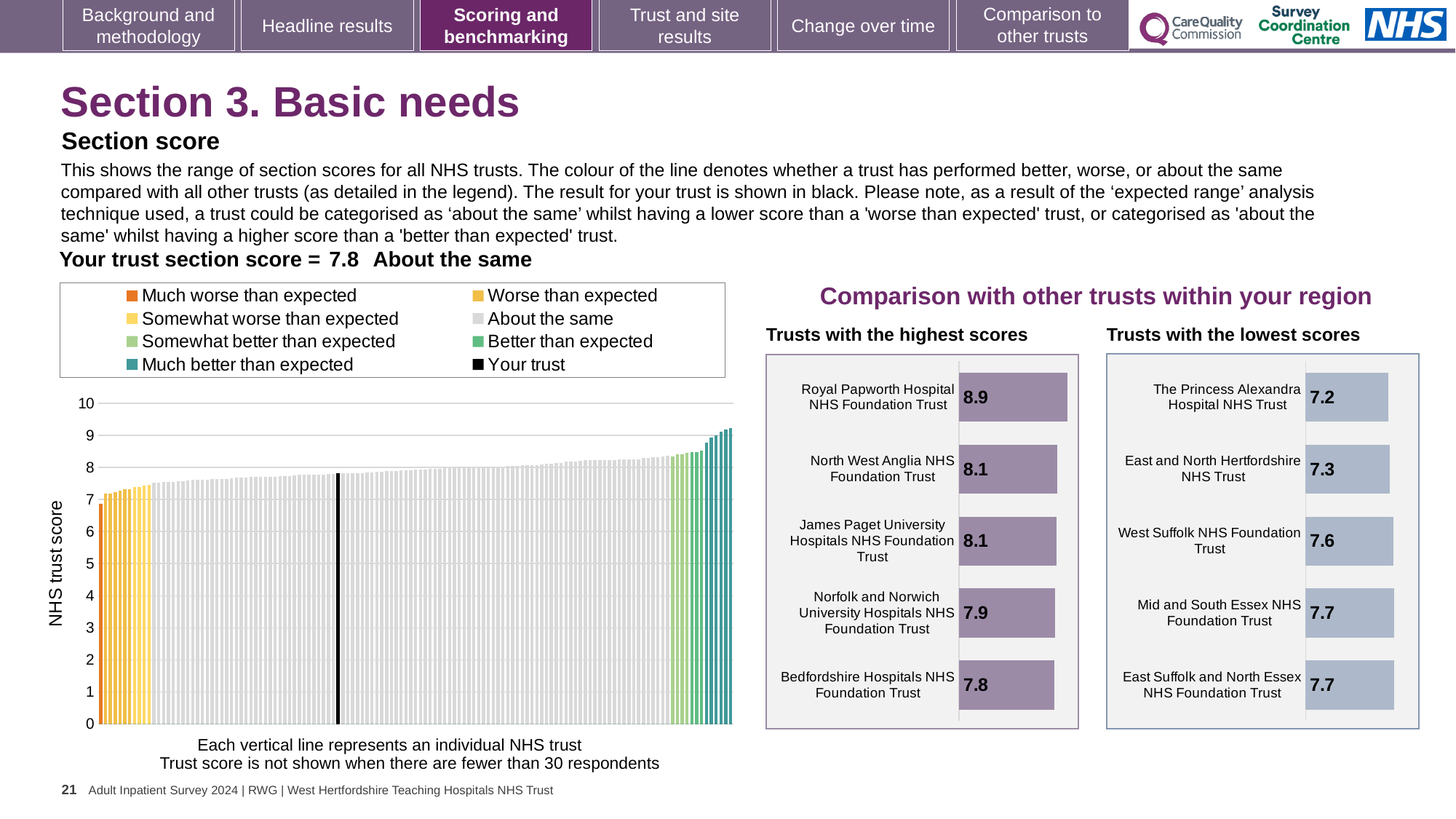
In the 'Trusts with the highest scores' chart, how many trusts are listed? 5 In the main 'NHS trust score' chart on the left, do the values rise or fall from left to right? Rise In the 'Trusts with the lowest scores' chart, which has the larger score: East and North Hertfordshire NHS Trust or West Suffolk NHS Foundation Trust? West Suffolk NHS Foundation Trust In the 'Trusts with the highest scores' chart, what is the score for Royal Papworth Hospital NHS Foundation Trust? 8.9 In the main 'NHS trust score' chart on the left, how many entries does the legend list? 8 In the 'Trusts with the lowest scores' chart, what is the score for West Suffolk NHS Foundation Trust? 7.6 In the 'Trusts with the highest scores' chart, what is the difference between the scores of Royal Papworth Hospital NHS Foundation Trust and Bedfordshire Hospitals NHS Foundation Trust? 1.1 What kind of chart is the main 'NHS trust score' chart on the left? Bar chart In the 'Trusts with the lowest scores' chart, what is the difference between the scores of East and North Hertfordshire NHS Trust and The Princess Alexandra Hospital NHS Trust? 0.1 In the 'Trusts with the highest scores' chart, which trust has the highest score? Royal Papworth Hospital NHS Foundation Trust According to the slide, what is your trust's section score for Basic needs? 7.8 In the 'Trusts with the lowest scores' chart, which trust has the lowest score? The Princess Alexandra Hospital NHS Trust